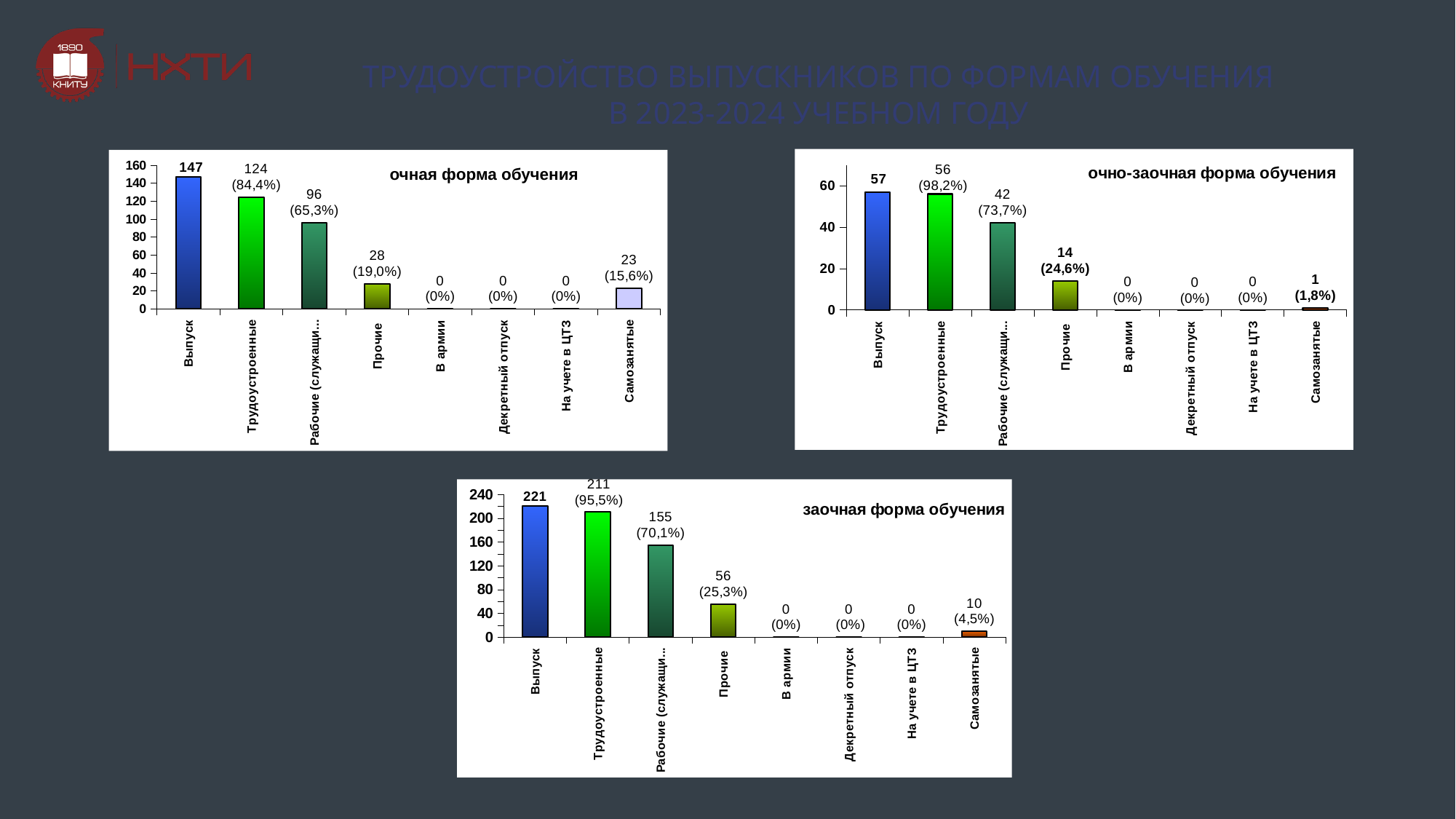
In the chart titled "очная форма обучения", is the value for Рабочие (служащи...) greater or less than 80? greater In the chart titled "заочная форма обучения", what is the difference between Трудоустроенные and Рабочие (служащи...)? 56 In the chart titled "очная форма обучения", what is the value for Выпуск? 147 In the chart titled "очная форма обучения", what is the difference between Выпуск and Трудоустроенные? 23 In the chart titled "очно-заочная форма обучения", which is larger: Рабочие (служащи...) or Прочие? Рабочие (служащи...) In the chart titled "заочная форма обучения", what is the value for Самозанятые? 10 In the chart titled "заочная форма обучения", which category has the highest value? Выпуск What type of chart is the chart titled "заочная форма обучения"? bar chart In the chart titled "очная форма обучения", what percentage is shown for Трудоустроенные? 84,4% In the chart titled "очно-заочная форма обучения", what is the value for Прочие? 14 How many categories are shown on the x axis of the chart titled "очно-заочная форма обучения"? 8 How many charts are shown on the slide? 3